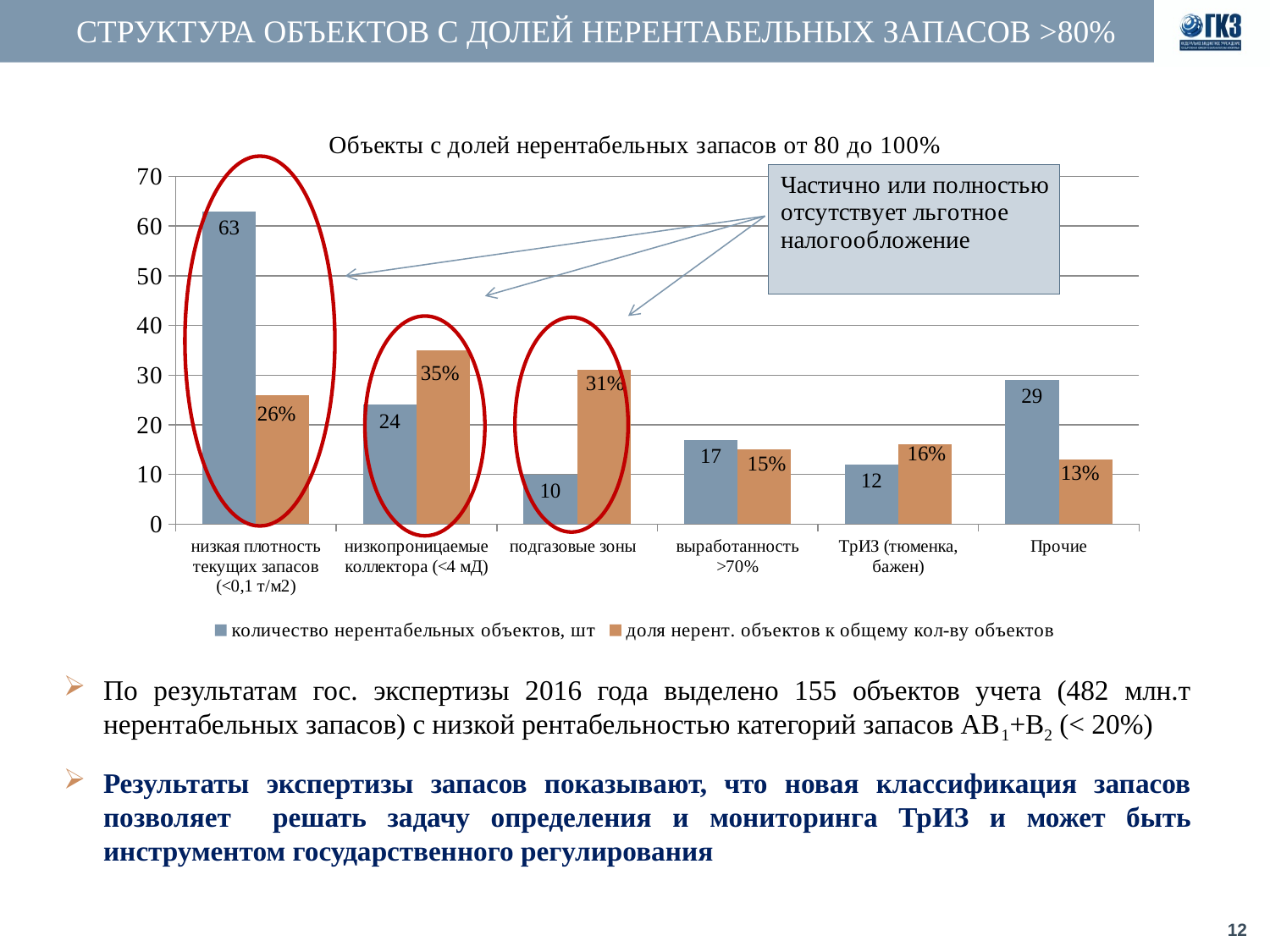
How many categories are shown on the x axis of the chart? 6 What type of chart is shown on the slide? bar chart What is the title of the chart? Объекты с долей нерентабельных запасов от 80 до 100% What is the share of unprofitable objects for the category 'Прочие'? 13% Which category has the highest number of unprofitable objects (blue series)? низкая плотность текущих запасов (<0,1 т/м2) What is the number of unprofitable objects (количество нерентабельных объектов, шт) for the category 'низкая плотность текущих запасов (<0,1 т/м2)'? 63 Which category has the lowest share of unprofitable objects (orange series)? Прочие What is the number of unprofitable objects for the category 'подгазовые зоны'? 10 What is the difference between the number of unprofitable objects for 'низкая плотность текущих запасов' and for 'Прочие'? 34 Which is larger: the number of unprofitable objects for 'выработанность >70%' or for 'ТрИЗ (тюменка, бажен)'? выработанность >70% How many series does the chart legend list? 2 What is the share of unprofitable objects (доля нерент. объектов к общему кол-ву объектов) for 'низкопроницаемые коллектора (<4 мД)'? 35%